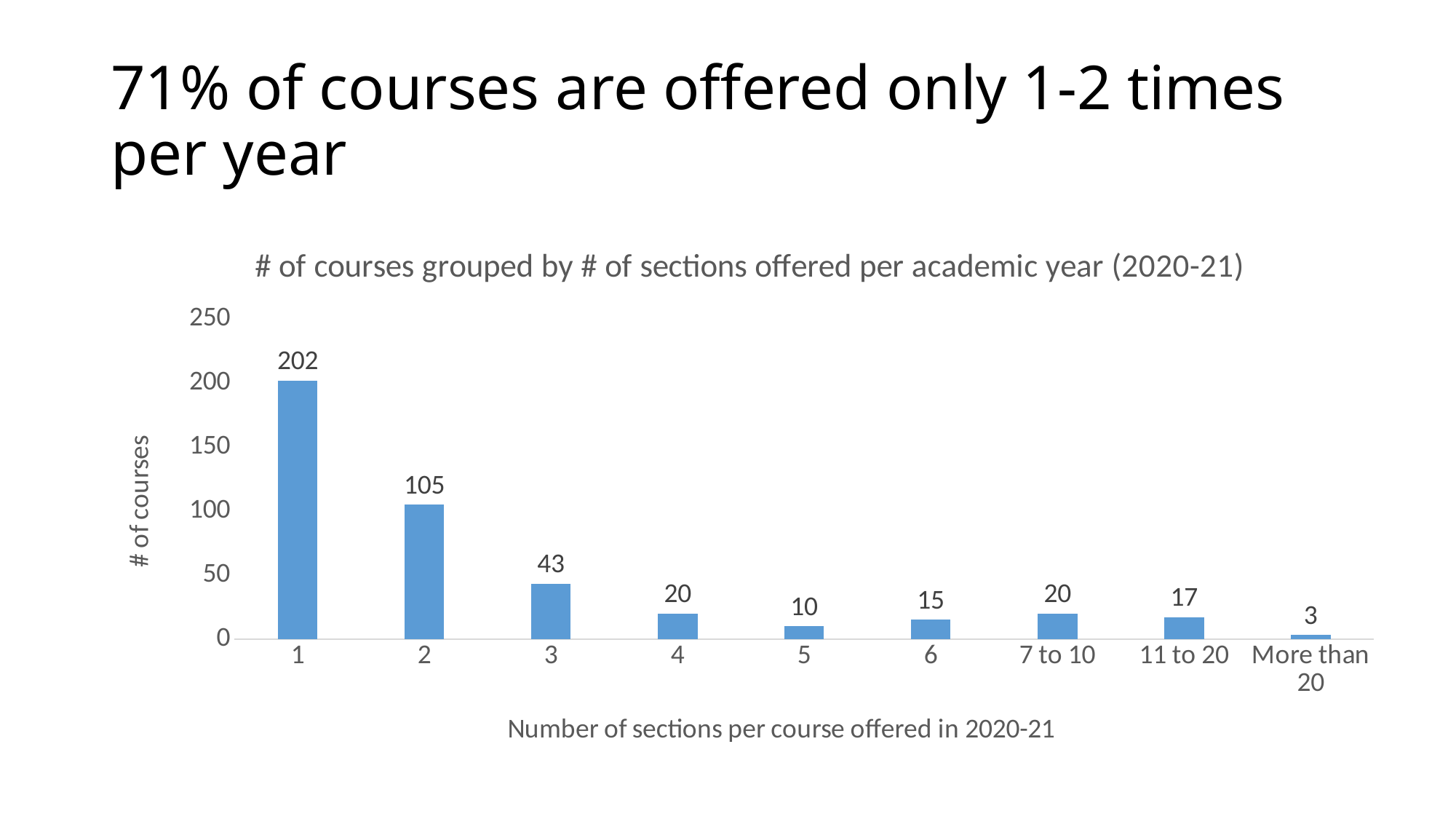
How many courses had 11 to 20 sections? 17 How many courses were offered with 1 section in 2020-21? 202 Which has more courses: 3 sections or 4 sections? 3 sections What is the title of the chart? # of courses grouped by # of sections offered per academic year (2020-21) Is the value for 5 sections greater or less than 50? less How many categories are shown on the x axis? 9 What kind of chart is shown on the slide? Bar chart Which category has the highest number of courses? 1 Which category has the lowest number of courses? More than 20 What is the difference between the number of courses with 1 section and the number with 2 sections? 97 What is the number of courses with 2 sections? 105 What is the label of the y axis? # of courses